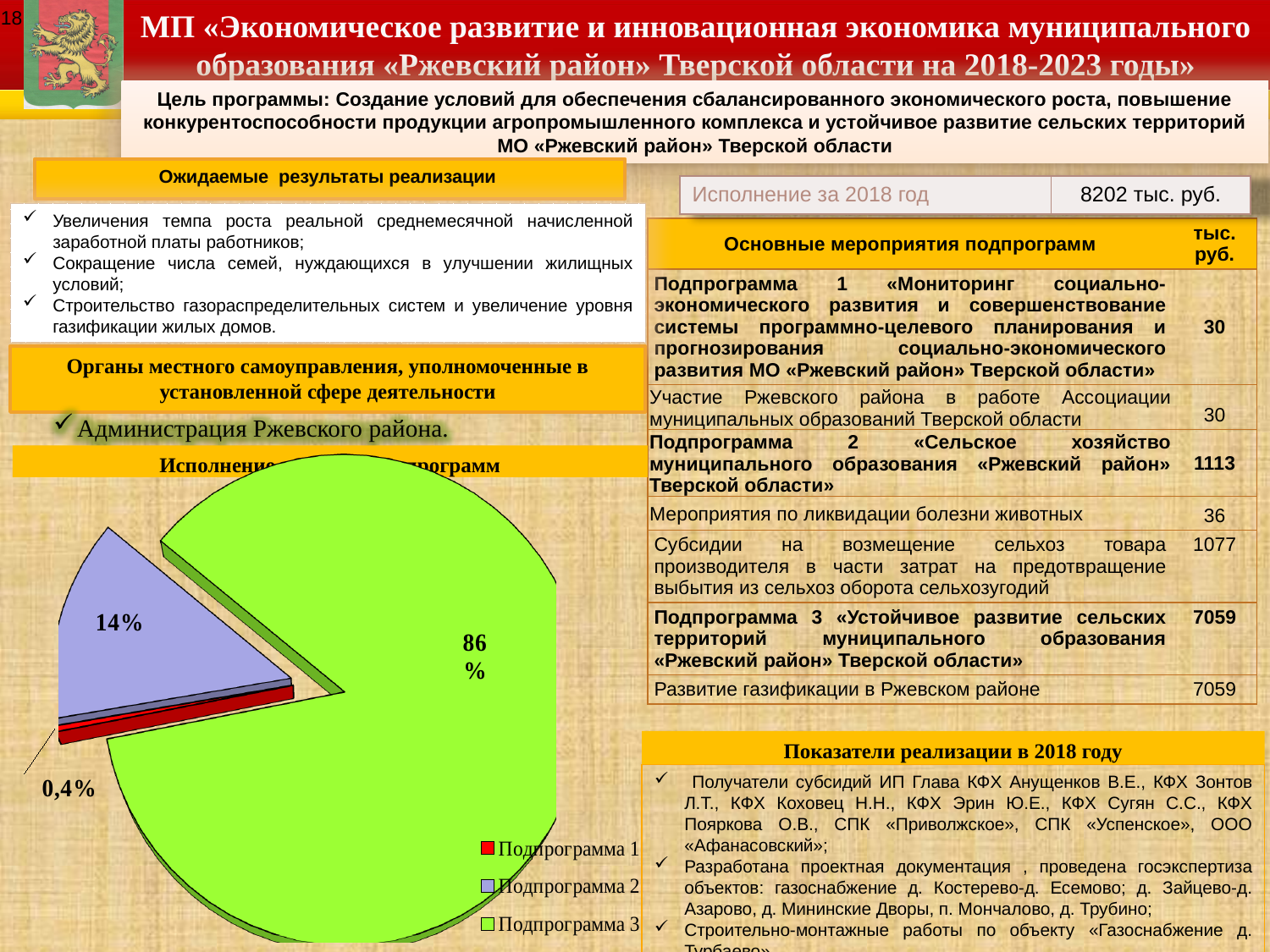
How many slices does the pie chart have? 3 What kind of chart is shown on the slide? pie chart What colour is the slice for Подпрограмма 1 in the pie chart? red Which subprogram has the largest slice of the pie? Подпрограмма 3 What share of the pie does Подпрограмма 2 have? 14% Which is larger in the pie chart, Подпрограмма 2 or Подпрограмма 3? Подпрограмма 3 How many entries does the legend of the pie chart list? 3 What share of the pie does Подпрограмма 1 have? 0,4% What share of the pie does Подпрограмма 3 have? 86% What colour is the slice for Подпрограмма 3 in the pie chart? green Which subprogram has the smallest slice of the pie? Подпрограмма 1 What is the difference in percentage points between the shares of Подпрограмма 3 and Подпрограмма 2? 72